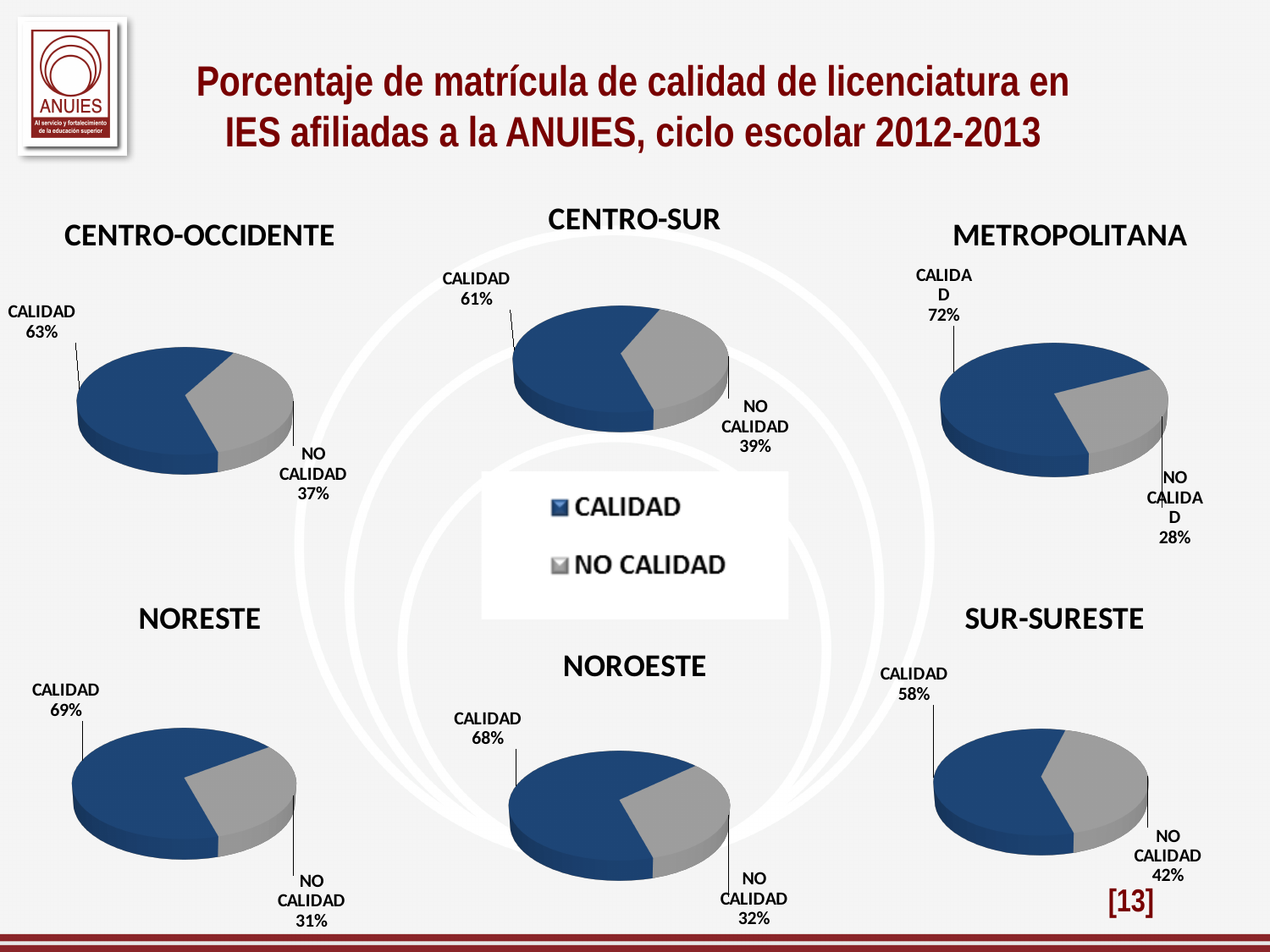
Which is larger: the CALIDAD percentage in the NORESTE chart or the CALIDAD percentage in the NOROESTE chart? NORESTE In the SUR-SURESTE pie chart, what percentage is labelled NO CALIDAD? 42% What is the difference between the CALIDAD percentage in the METROPOLITANA chart and the CALIDAD percentage in the SUR-SURESTE chart? 14% In the NORESTE pie chart, what percentage is labelled NO CALIDAD? 31% Across the six pie charts, which region has the lowest CALIDAD percentage? SUR-SURESTE What type of chart is used for each region on this slide? Pie chart In the CENTRO-SUR pie chart, what percentage is labelled NO CALIDAD? 39% How many entries does the shared legend list? 2 In the METROPOLITANA pie chart, what percentage is labelled CALIDAD? 72% Across the six pie charts, which region has the highest CALIDAD percentage? METROPOLITANA In the CENTRO-OCCIDENTE pie chart, what percentage is labelled CALIDAD? 63% In the NOROESTE pie chart, what percentage is labelled CALIDAD? 68%